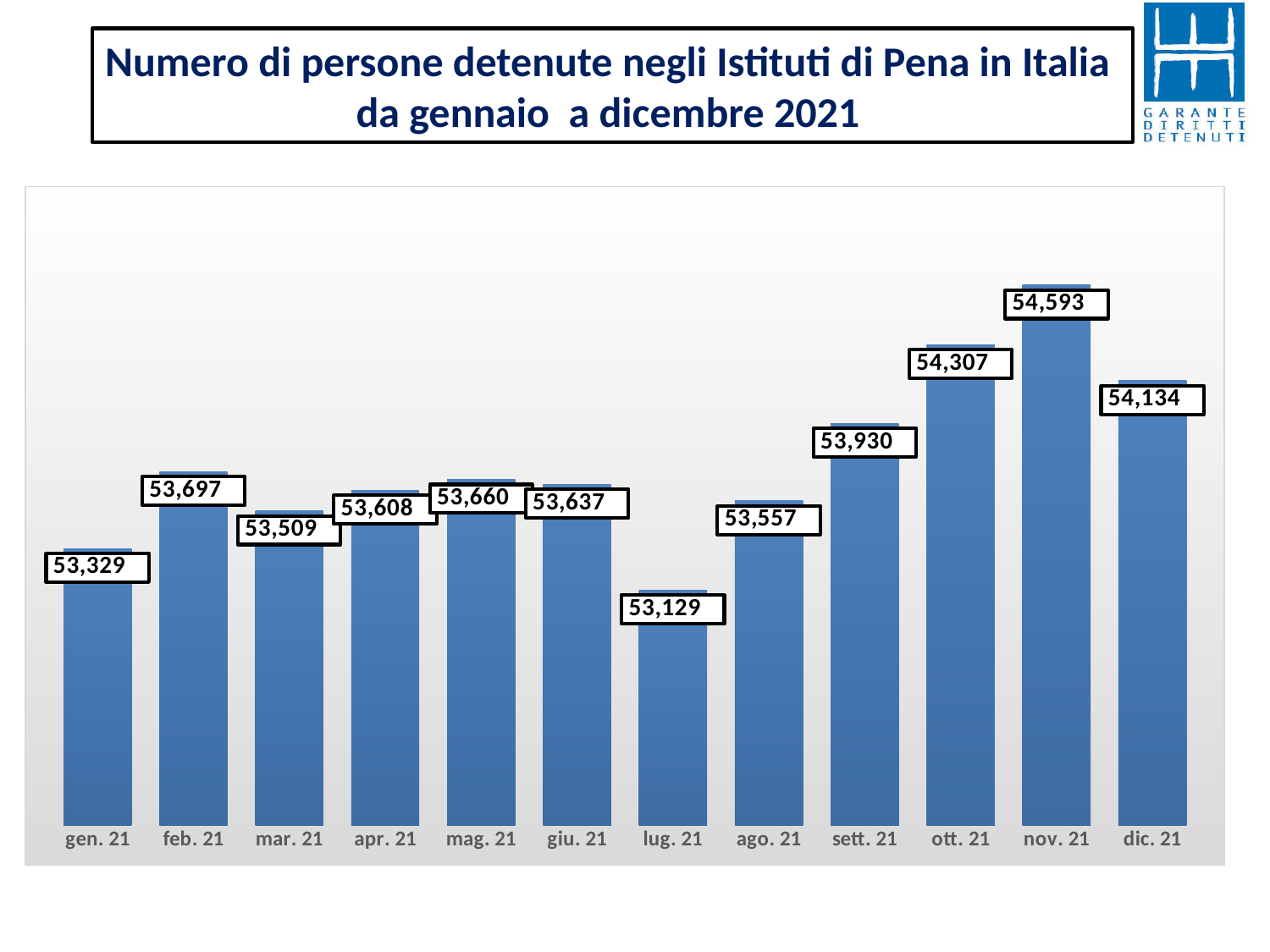
What is the number of detained persons shown for gen. 21? 53,329 How many months are shown on the x axis? 12 What kind of chart is shown on the slide? bar chart What value is shown for ott. 21? 54,307 What is the difference between the values for sett. 21 and ago. 21? 373 Which month has the lowest value? lug. 21 Which month has the highest value? nov. 21 What is the difference between the values for nov. 21 and dic. 21? 459 What is the title of the slide? Numero di persone detenute negli Istituti di Pena in Italia da gennaio a dicembre 2021 What value is shown for lug. 21? 53,129 Do the values rise or fall from ago. 21 to nov. 21? rise Which is larger, the value for feb. 21 or the value for mar. 21? feb. 21